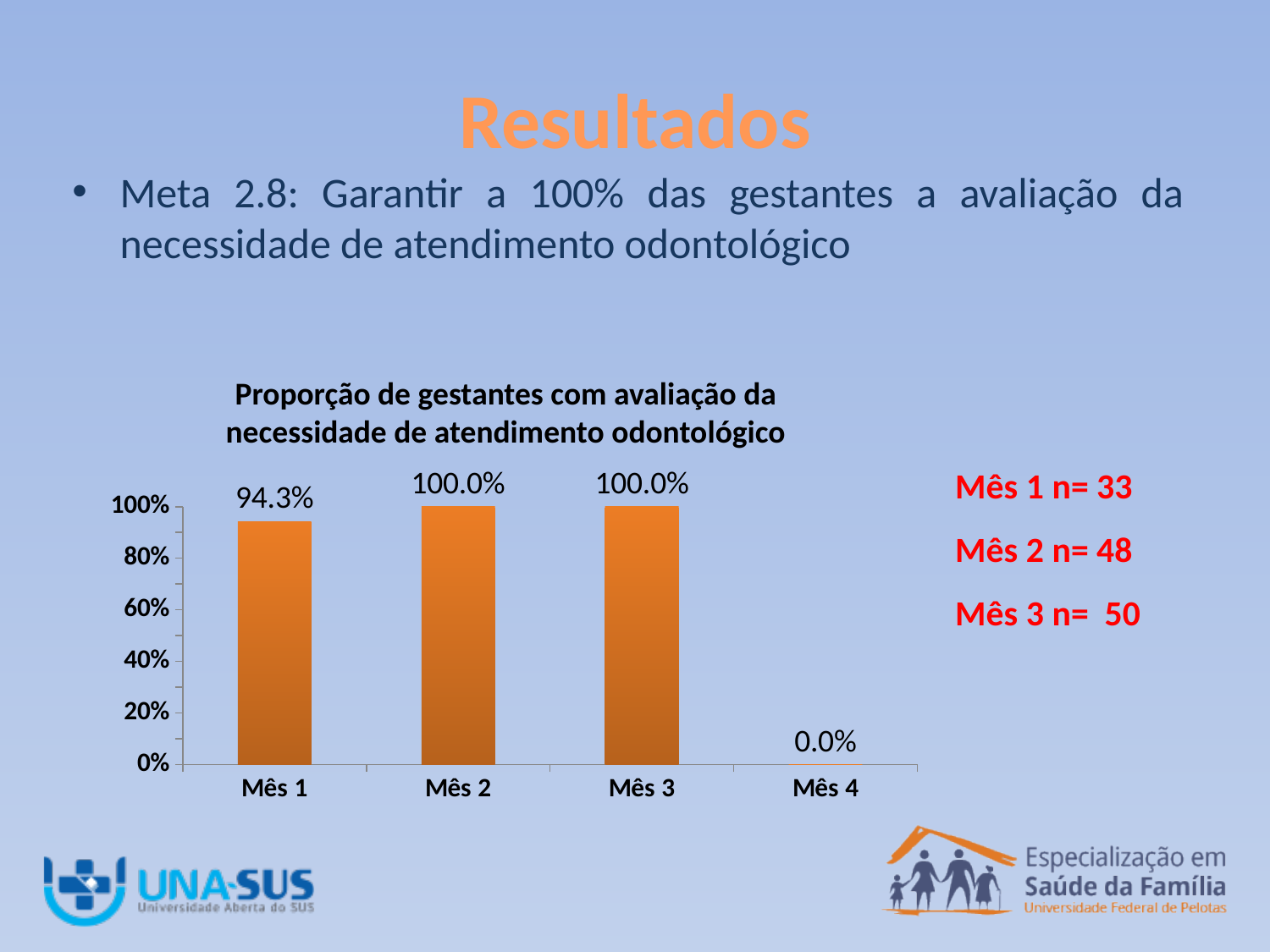
What is the value for Mês 1? 94.3% Do the values rise or fall from Mês 1 to Mês 2? rise What is the difference between the values for Mês 2 and Mês 1? 5.7% What is the value for Mês 4? 0.0% Which is larger, the value for Mês 1 or the value for Mês 3? Mês 3 How many categories are shown on the x axis? 4 What colour are the bars in the chart? orange Which category has the lowest value? Mês 4 Is the value for Mês 1 greater or less than 80%? greater What kind of chart is shown on the slide? bar chart What is the title of the chart? Proporção de gestantes com avaliação da necessidade de atendimento odontológico What is the value for Mês 2? 100.0%